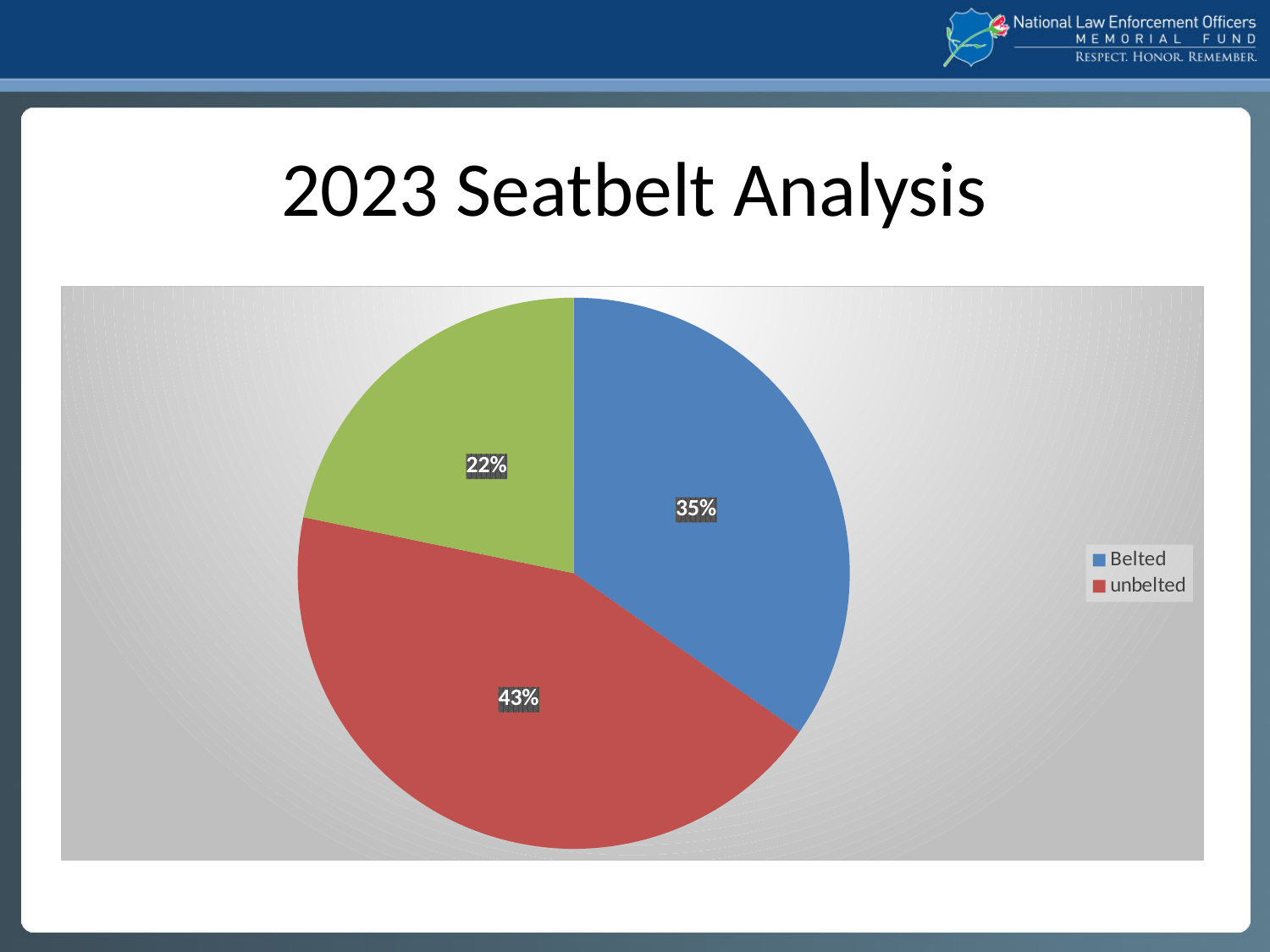
What percentage is shown on the green slice of the pie? 22% What is the difference in percentage points between the unbelted slice and the Belted slice? 8 What is the title of the chart on the slide? 2023 Seatbelt Analysis Which is larger, the Belted slice or the unbelted slice? unbelted How many slices does the pie chart have? 3 What percentage of the pie is labelled unbelted? 43% How many entries does the legend list? 2 What percentage of the pie is labelled Belted? 35% What kind of chart is shown on the slide? pie chart Which slice of the pie is the largest? unbelted What colour is the Belted slice in the pie chart? blue Which slice of the pie is the smallest? the green slice (22%)